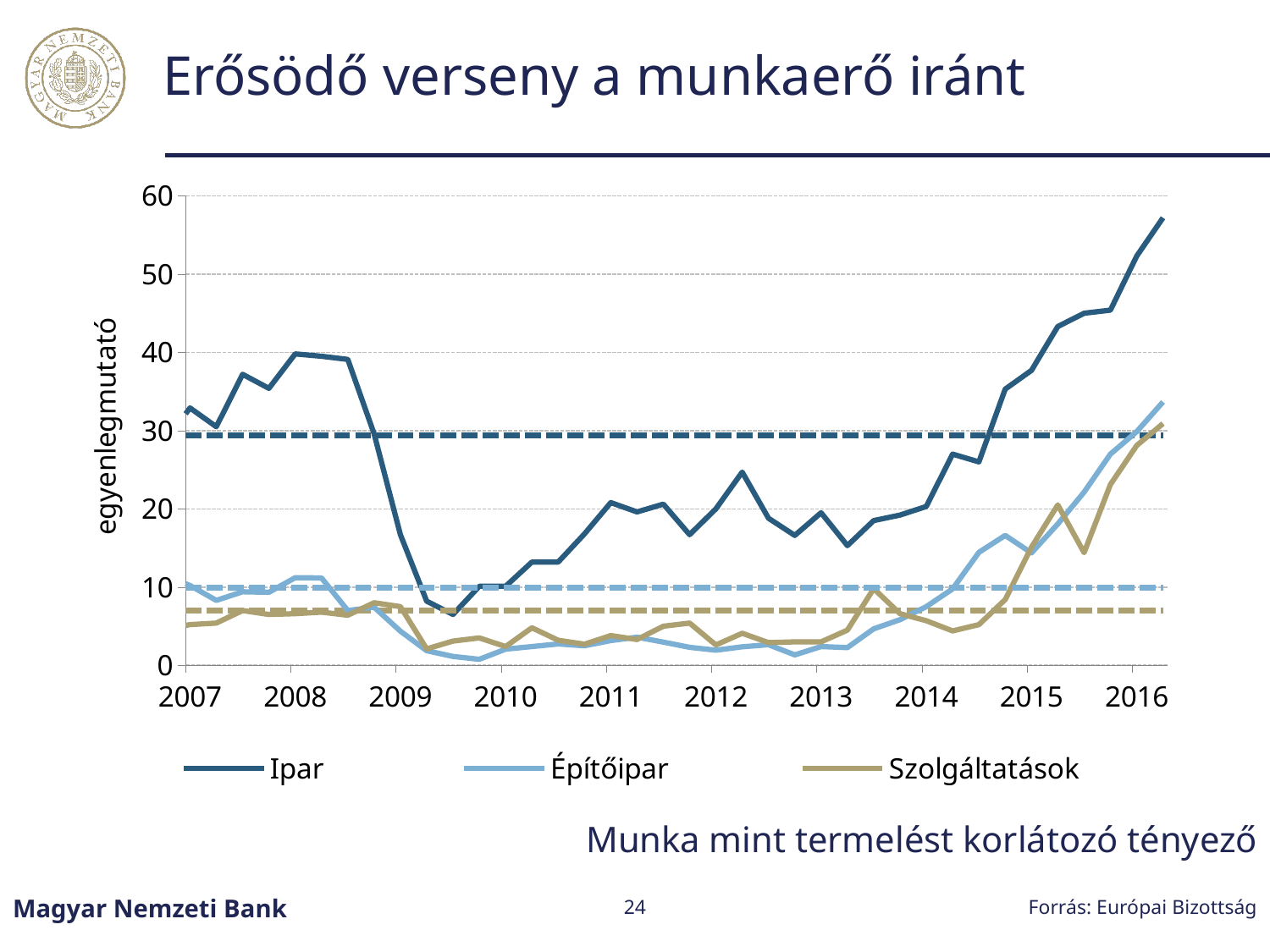
Which series has the highest value at the end of the chart in 2016? Ipar Is the value for Ipar at the end of the series in 2016 greater or less than 50? greater What kind of chart is shown on the slide? line chart How many year labels are shown on the x axis? 10 Does the Ipar series rise or fall between 2008 and 2009? falls Is the value for Építőipar at the start of 2007 greater or less than 20? less Is the value for Ipar at the start of 2008 greater or less than 30? greater What is the label of the vertical axis? egyenlegmutató At 2012, which is larger: the value for Ipar or the value for Építőipar? Ipar Which series has the lowest value at the start of the chart in 2007? Szolgáltatások Does the Ipar series rise or fall between 2014 and 2016? rises How many series does the legend list? 3